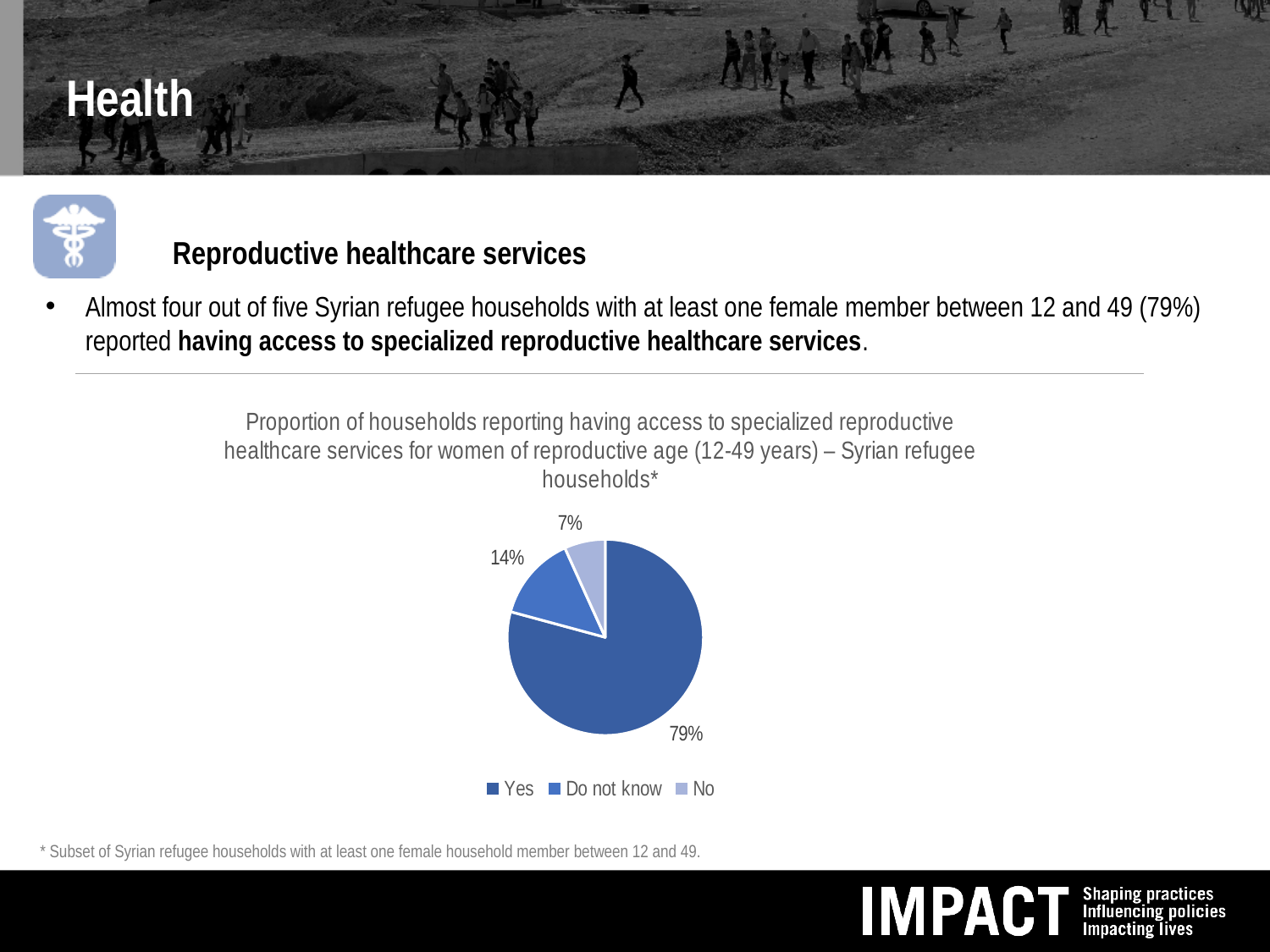
What is the difference in percentage points between the 'Do not know' and 'No' slices? 7 How many categories does the legend of the pie chart list? 3 Which legend entry is shown in the lightest shade of blue? No What is the difference in percentage points between the 'Yes' and 'Do not know' slices? 65 What percentage of households reported 'Yes' to having access to specialized reproductive healthcare services? 79% What type of chart is shown on the slide? pie chart Which is larger, the 'Do not know' slice or the 'No' slice? Do not know What percentage of households answered 'Do not know'? 14% Which response category has the largest share of the pie? Yes How many slices does the pie chart have? 3 What percentage of households answered 'No'? 7% Which response category has the smallest share of the pie? No